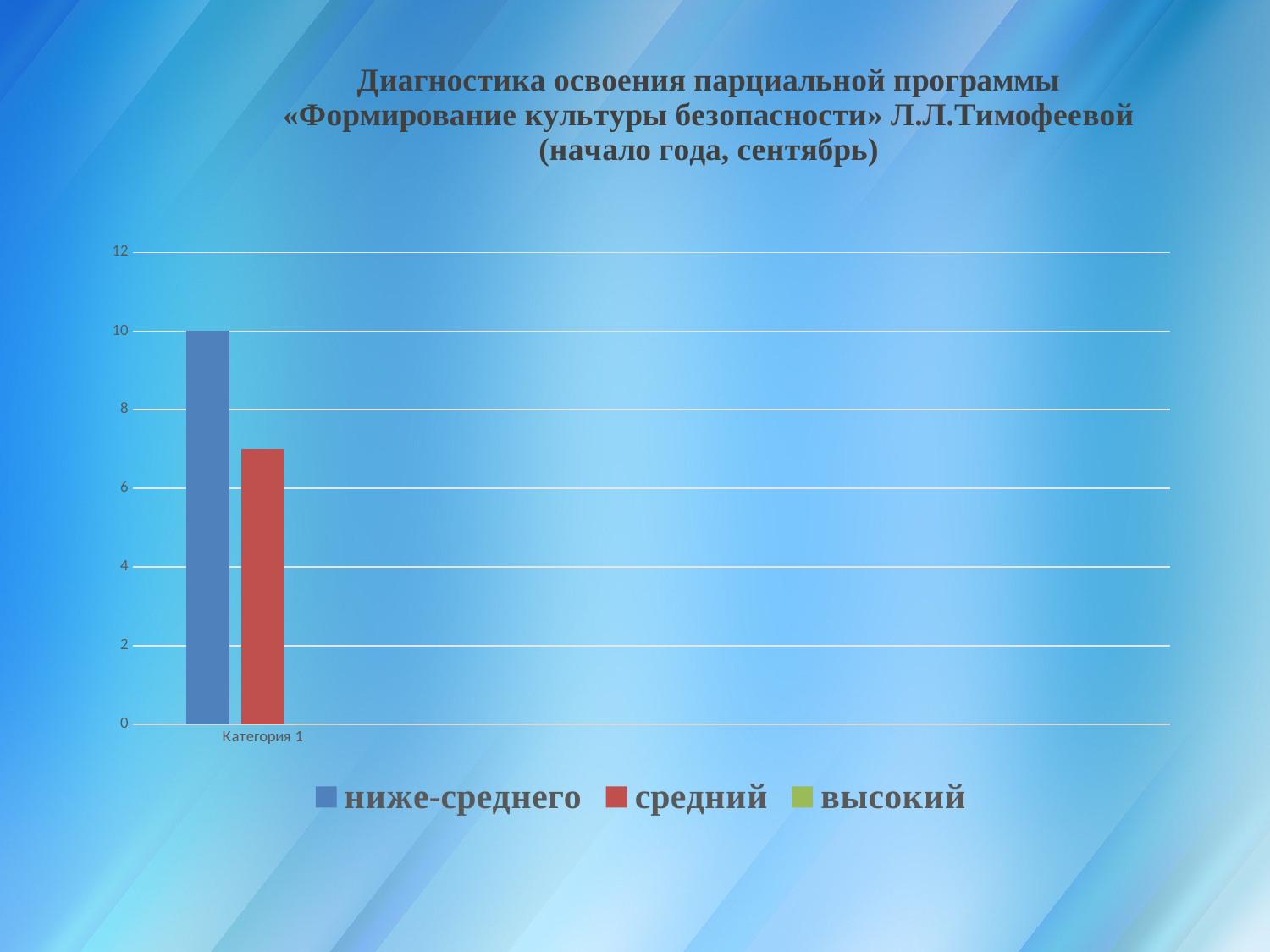
How many series does the legend list? 3 Which series has the highest bar in the chart? ниже-среднего Which is larger, the "ниже-среднего" bar or the "средний" bar? ниже-среднего Is the value for "средний" greater or less than 8? less What is the value of the "ниже-среднего" bar for Категория 1? 10 Is the value for "ниже-среднего" greater or less than 8? greater Is the value for "средний" greater or less than 6? greater What colour is used for the "средний" series in the legend? red How many categories are shown on the x axis? 1 What kind of chart is shown on the slide? bar chart What is the label of the category on the x axis? Категория 1